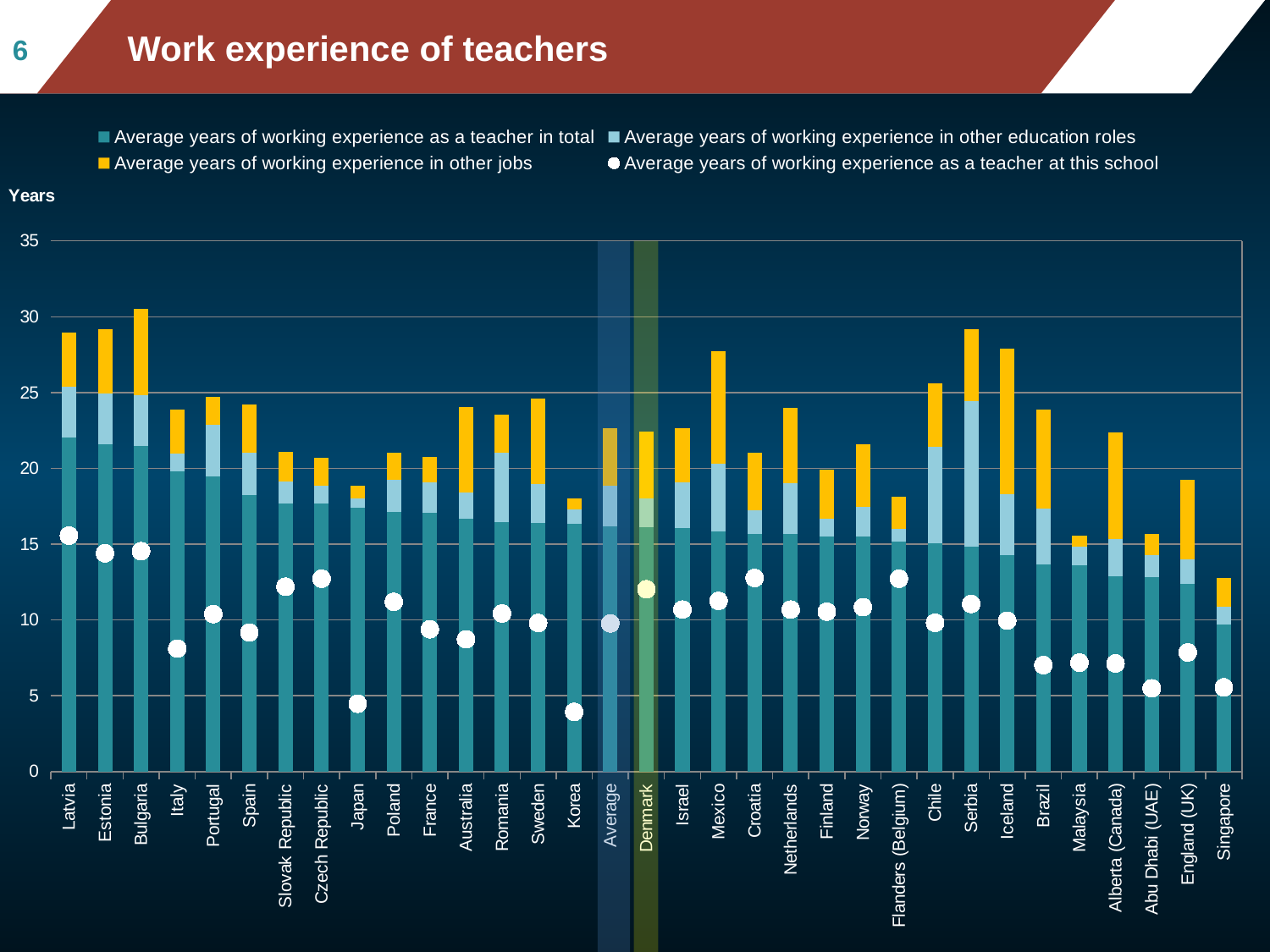
Is the average years of working experience as a teacher at this school for Korea greater or less than 5? less How many countries or regions (including Average) are shown along the x axis? 33 How many series does the legend list? 4 What is the label on the vertical axis? Years Which country has the lowest average years of working experience as a teacher at this school (the white dot)? Korea Which has a taller stacked bar, Mexico or Finland? Mexico Is the average years of working experience as a teacher at this school for Denmark greater or less than 10? greater Is the total stacked bar for Singapore greater or less than 15 years? less Which country has the shortest stacked bar (lowest total years of working experience)? Singapore What kind of chart is shown on the slide? bar chart Which country has the tallest stacked bar (highest total years of working experience)? Bulgaria